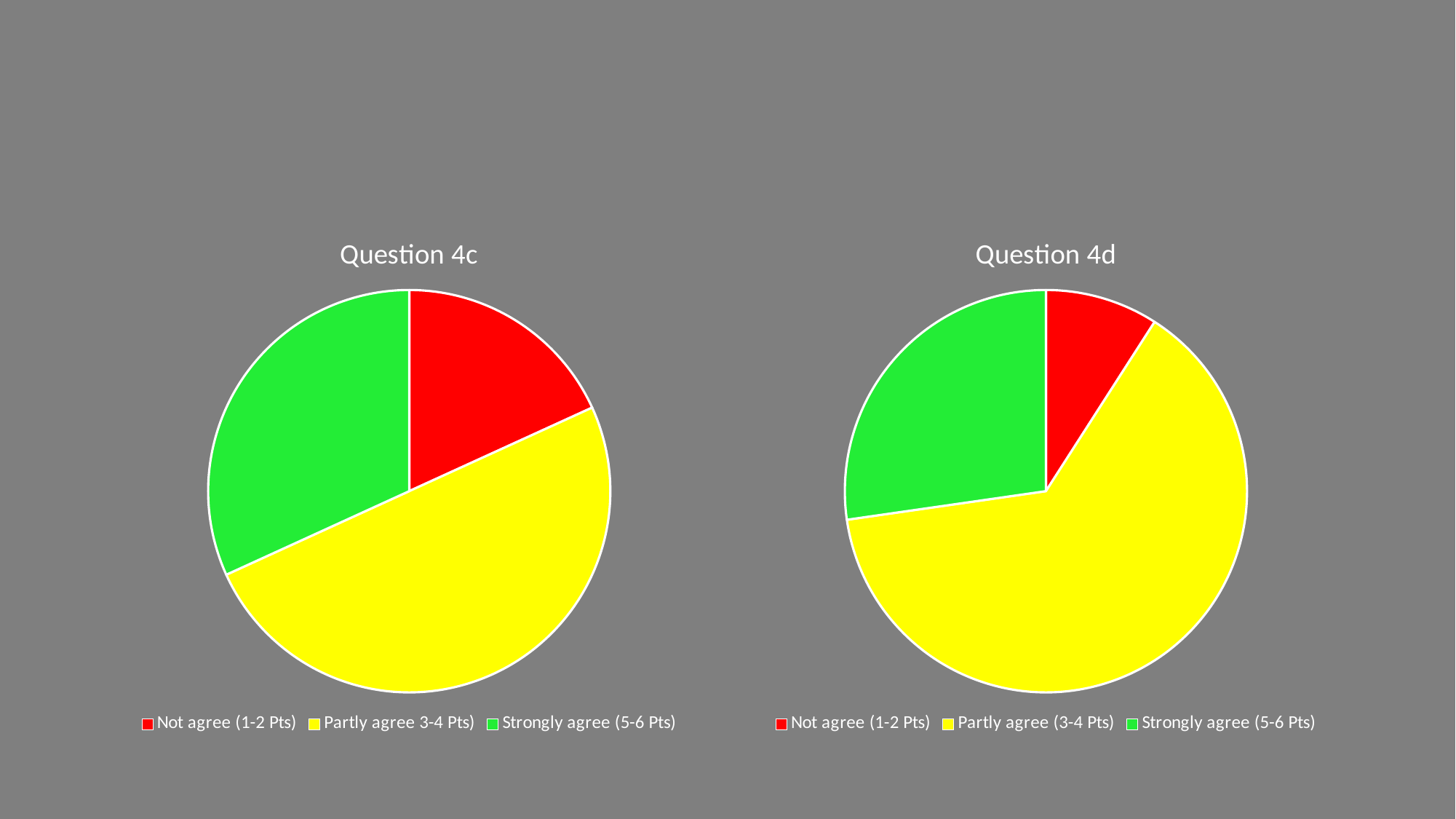
Which chart has the larger "Not agree (1-2 Pts)" slice, Question 4c or Question 4d? Question 4c In the "Question 4c" chart, which slice is larger: Partly agree or Strongly agree? Partly agree In the "Question 4c" chart, which category has the smallest slice? Not agree (1-2 Pts) In the "Question 4d" chart, which category has the largest slice? Partly agree (3-4 Pts) In the "Question 4c" chart, which category has the largest slice? Partly agree 3-4 Pts) In the "Question 4c" chart, how many slices does the pie have? 3 What kind of chart is shown under the title "Question 4d"? Pie chart In the "Question 4d" chart, which category has the smallest slice? Not agree (1-2 Pts) What is the title of the chart on the right side of the slide? Question 4d In the "Question 4d" chart, how many categories does the legend list? 3 What colour represents "Strongly agree (5-6 Pts)" in the charts? Green What kind of chart is shown under the title "Question 4c"? Pie chart